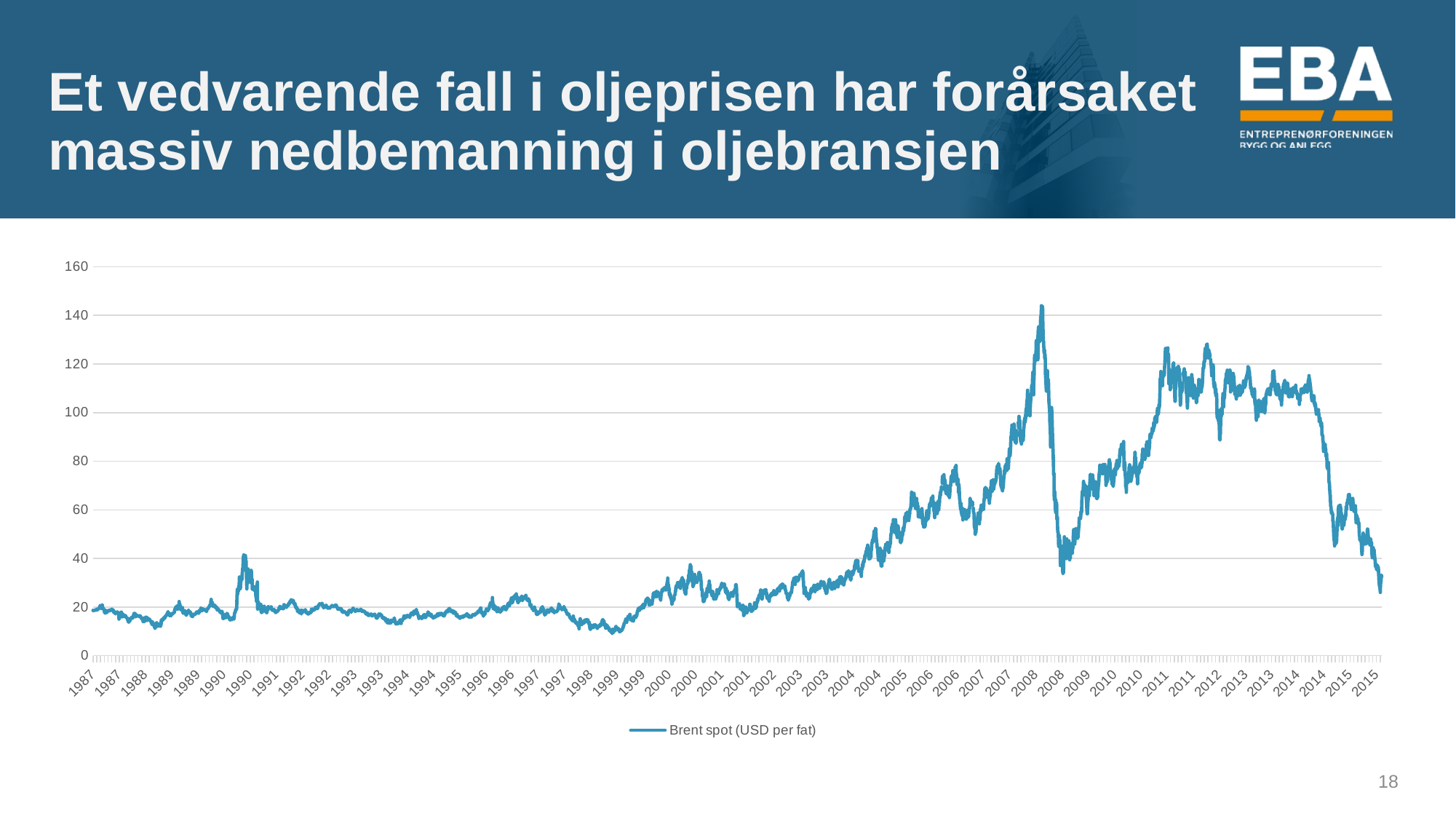
Does the Brent spot price rise or fall from 2003 to mid-2008? rise Is the Brent spot price during 1998 greater or less than 20? less What is the name of the series shown in the legend? Brent spot (USD per fat) Does the Brent spot price rise or fall from 2014 to 2015? fall Is the peak value of the Brent spot price in 2008 greater or less than 120? greater How many series does the legend list? 1 Which is larger, the Brent spot price in 2012 or in 1995? 2012 What is the highest value shown on the vertical axis? 160 In which year does the Brent spot price reach its highest peak? 2008 What kind of chart is shown on the slide? line chart Is the Brent spot price at the end of 2015 greater or less than 40? less